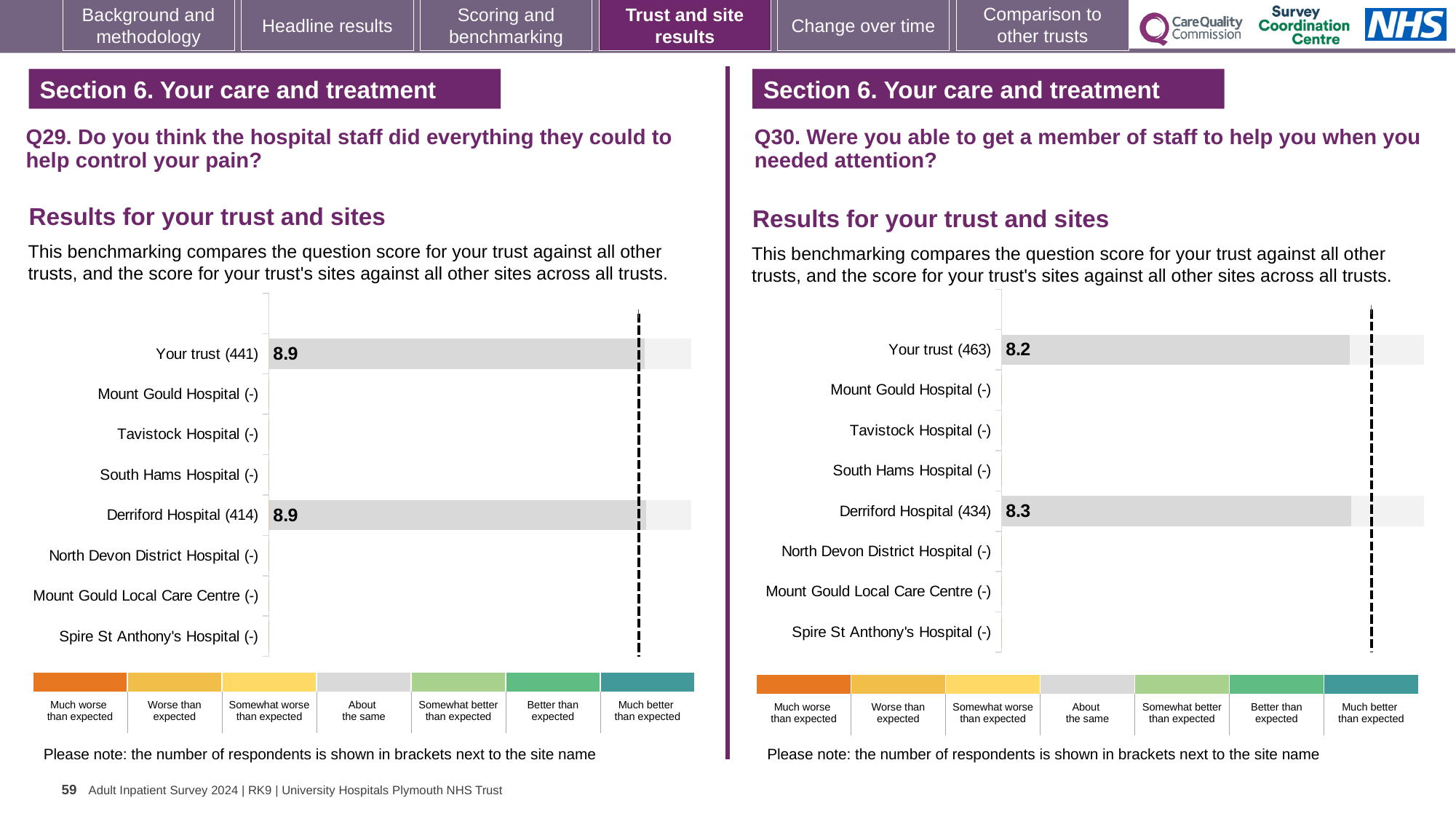
On the Q30 chart (right), how many respondents are shown in brackets for Your trust? 463 On the Q29 chart (left), how many respondents are shown in brackets for Derriford Hospital? 414 On the Q30 chart (right), what is the difference between the Derriford Hospital score and the Your trust score? 0.1 On the Q29 chart (left), what is the score for Derriford Hospital? 8.9 How many site categories are listed on the Q29 chart (left)? 8 On the Q30 chart (right), what is the score for Your trust? 8.2 On the Q29 chart (left), what is the score for Your trust? 8.9 On the Q29 chart (left), is the score for Your trust greater or less than the score for Derriford Hospital, or are they equal? Equal On the Q30 chart (right), what is the score for Derriford Hospital? 8.3 What type of chart is used on the Q29 chart (left)? Bar chart How many site categories are listed on the Q30 chart (right)? 8 On the Q30 chart (right), which has the higher score, Your trust or Derriford Hospital? Derriford Hospital